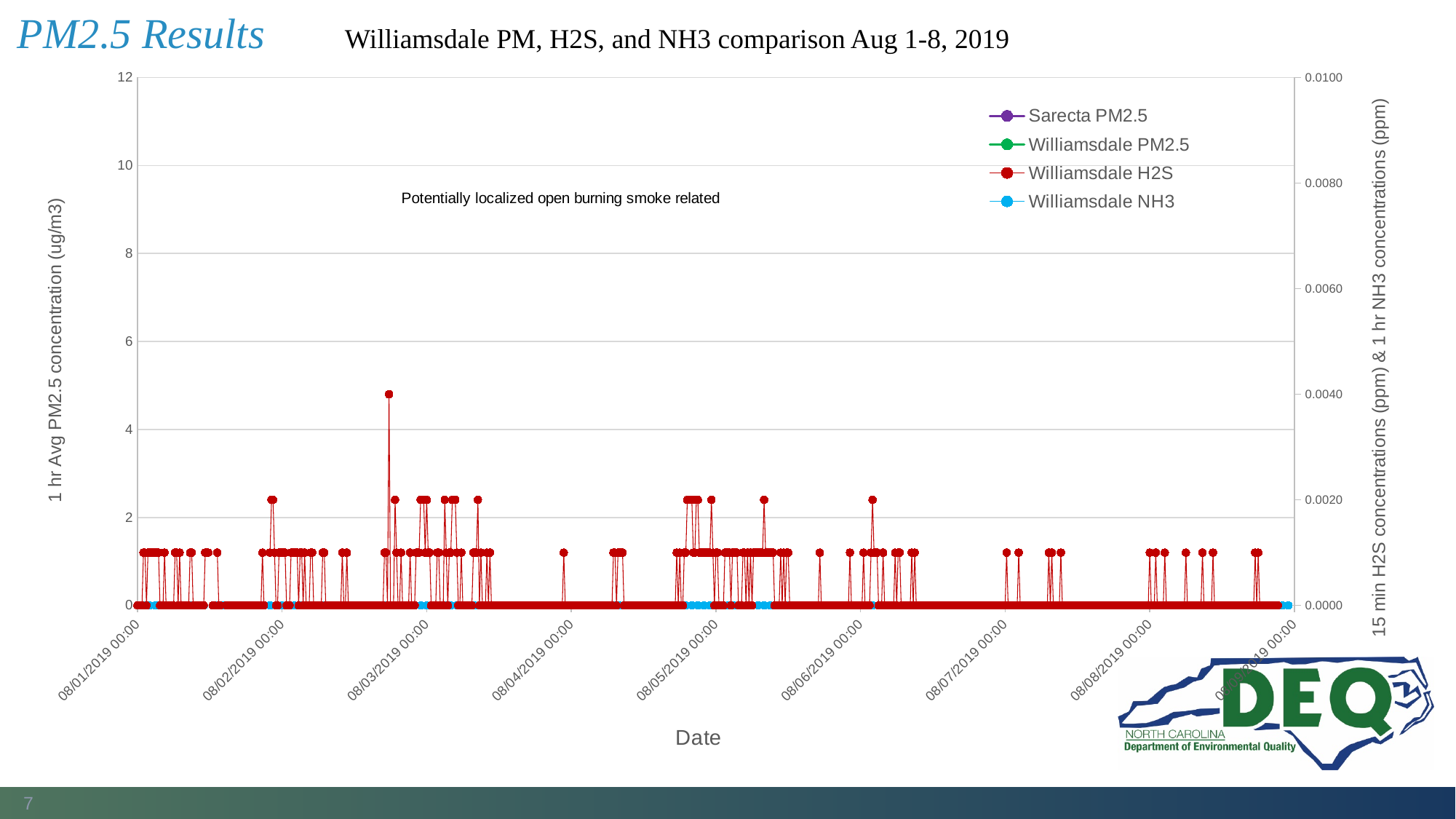
How many series does the chart legend list? 4 What is the title of the chart? Williamsdale PM, H2S, and NH3 comparison Aug 1-8, 2019 Is the highest Williamsdale H2S value greater or less than 0.0020 ppm? greater What is the label of the x axis? Date Is the Williamsdale NH3 series greater or less than 0.0020 ppm throughout the period? less Which right-axis tick does the highest Williamsdale H2S spike reach? 0.0040 Is the highest Williamsdale H2S value greater or less than 0.0060 ppm? less How many date labels are shown along the x axis? 9 What kind of chart is shown on the slide? Line chart What is the maximum value shown on the right y axis? 0.0100 What is the maximum value shown on the left y axis? 12 Which series is plotted in red? Williamsdale H2S